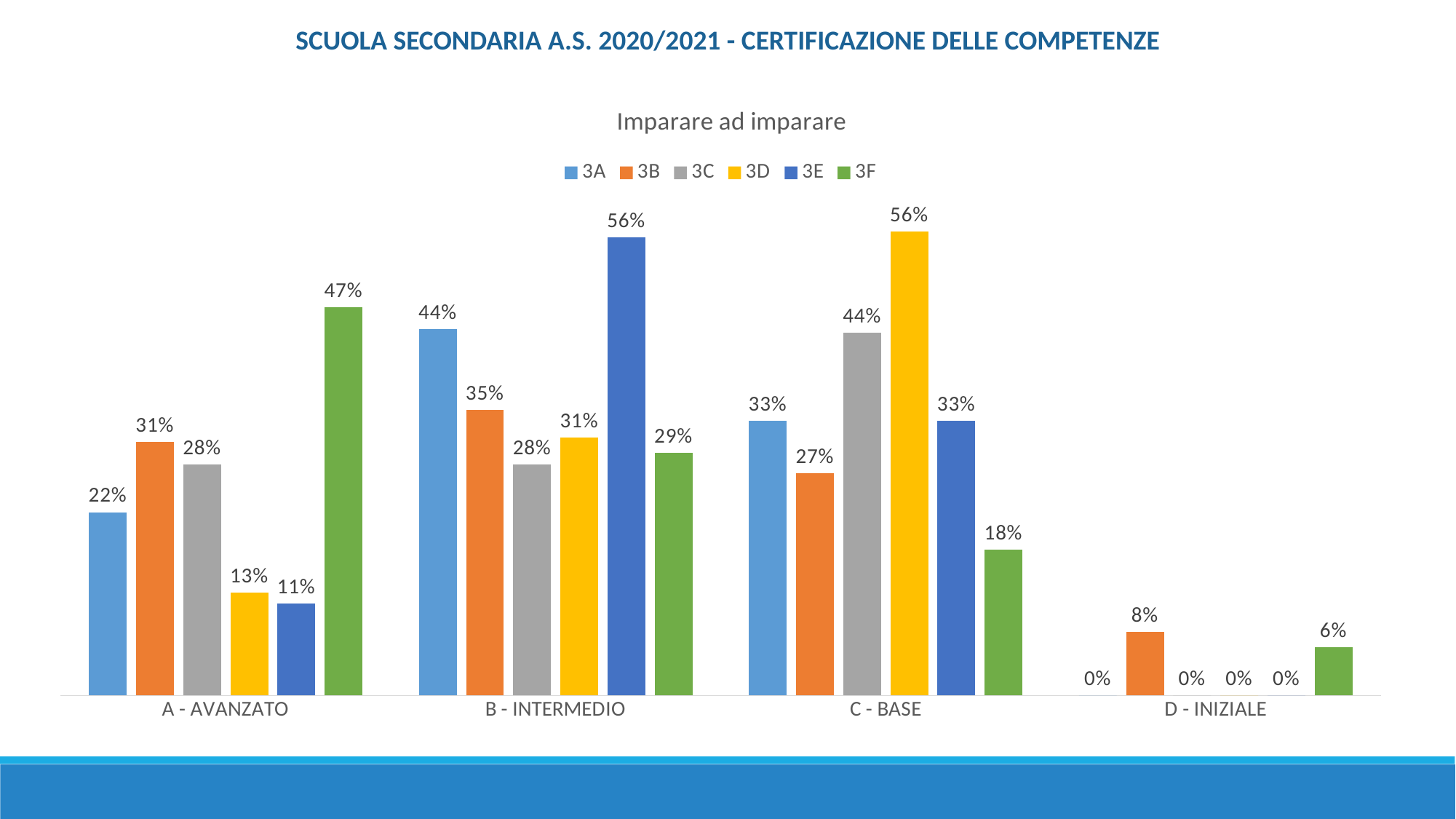
How many series have a value of 0% in the D - INIZIALE category? 4 What is the difference between the 3A and 3B values in the B - INTERMEDIO category? 9% Which series has the highest value in the C - BASE category? 3D How many categories are shown on the x axis? 4 What kind of chart is shown on the slide? Bar chart What is the value for 3F in the A - AVANZATO category? 47% What is the value for 3B in the D - INIZIALE category? 8% Which series has the lowest value in the A - AVANZATO category? 3E What is the title of the chart? Imparare ad imparare In the C - BASE category, which is larger: the value for 3C or the value for 3F? 3C How many series does the legend list? 6 What is the value for 3E in the B - INTERMEDIO category? 56%